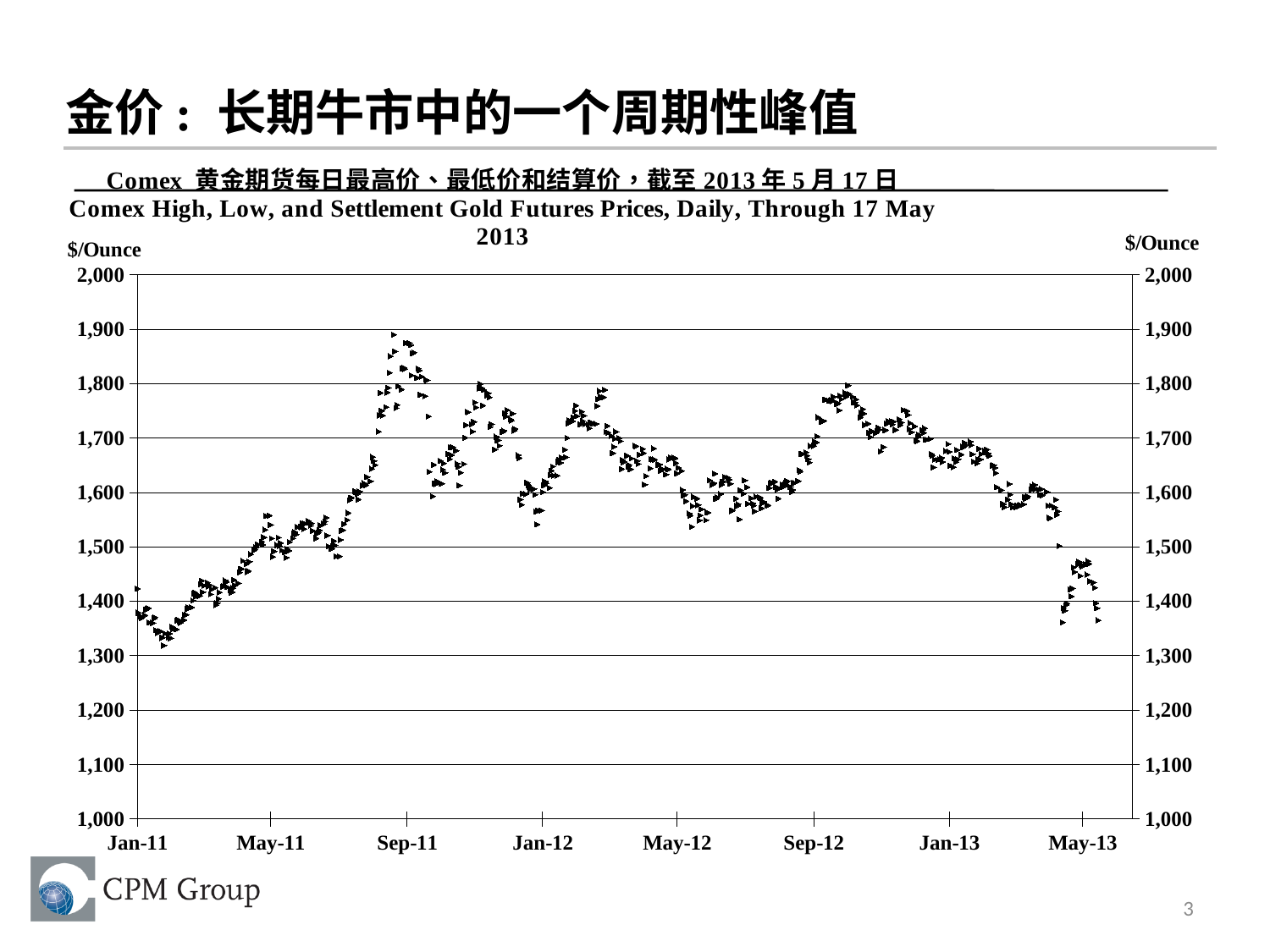
Do the plotted gold prices rise or fall between Jan-11 and Sep-11? rise Around Jan-11, are the plotted gold prices greater or less than 1,500? less Do the plotted gold prices rise or fall between Jan-13 and May-13? fall What kind of chart is shown on the slide? scatter chart Around Sep-11, are the plotted gold prices greater or less than 1,800? greater How many labels are shown on the x axis of the chart? 8 What unit is shown on the vertical axis of the chart? $/Ounce Through what date does the chart's data run, according to its title? 17 May 2013 Around Jan-13, are the plotted gold prices greater or less than 1,600? greater Around which x-axis label do the plotted gold prices reach their highest point? Sep-11